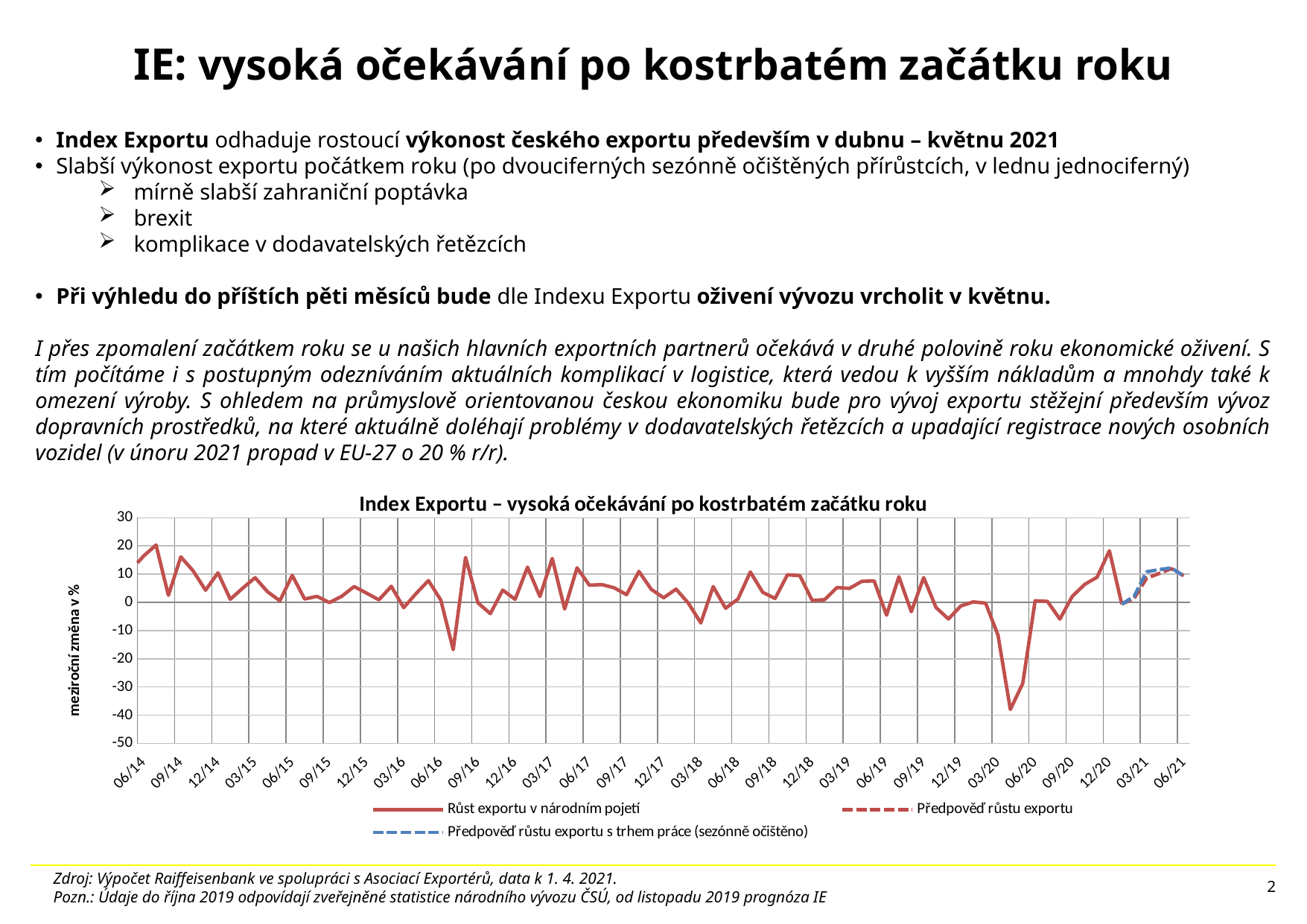
How many labels are shown on the x axis of the chart? 29 What is the label of the vertical axis of the chart? meziroční změna v % Is the lowest value of the solid line 'Růst exportu v národním pojetí' greater or less than -30? less Which is larger on the solid line: the value at 12/20 or the value at 06/20? 12/20 Does the solid line 'Růst exportu v národním pojetí' rise or fall between 03/20 and 06/20? rise What is the title of the chart? Index Exportu – vysoká očekávání po kostrbatém začátku roku What is the highest value shown on the vertical axis of the chart? 30 What kind of chart is shown on the slide? line chart Is the value of the solid line 'Růst exportu v národním pojetí' at 12/20 greater or less than 10? greater How many series does the chart legend list? 3 Does the solid line 'Růst exportu v národním pojetí' rise or fall between 06/20 and 12/20? rise